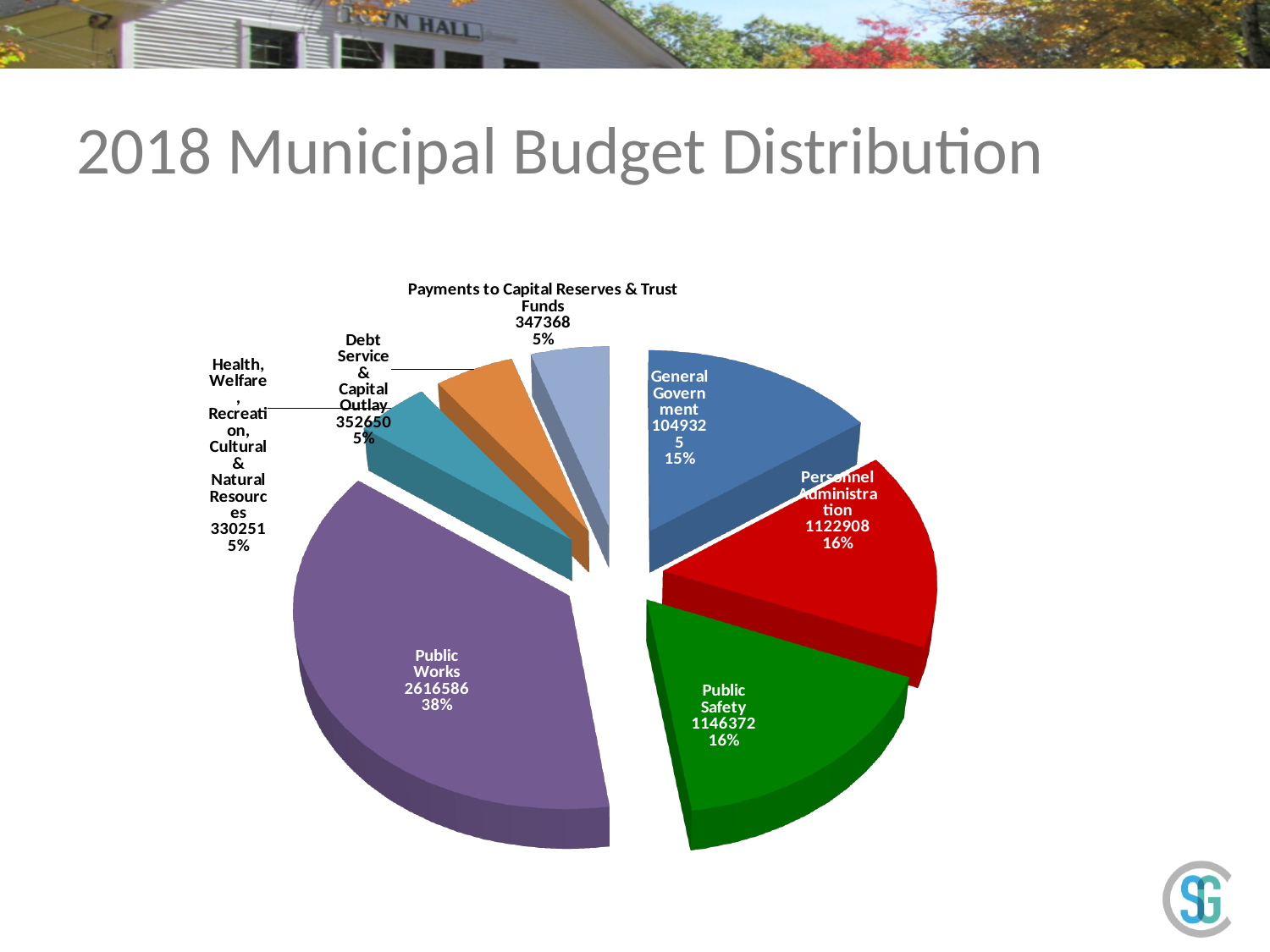
What is the value shown for Debt Service & Capital Outlay? 352650 What is the value shown for Public Works? 2616586 What is the value shown for General Government? 1049325 What type of chart is shown on the slide? Pie chart What is the title of the slide containing the chart? 2018 Municipal Budget Distribution Which category has the largest slice of the pie? Public Works What share of the pie does Public Works represent? 38% What is the value shown for Payments to Capital Reserves & Trust Funds? 347368 Which is larger, the value for Public Works or the value for Public Safety? Public Works What percentage of the budget does Public Safety represent? 16% How many slices does the pie chart have? 7 What is the difference between the values for Public Works and Public Safety? 1470214